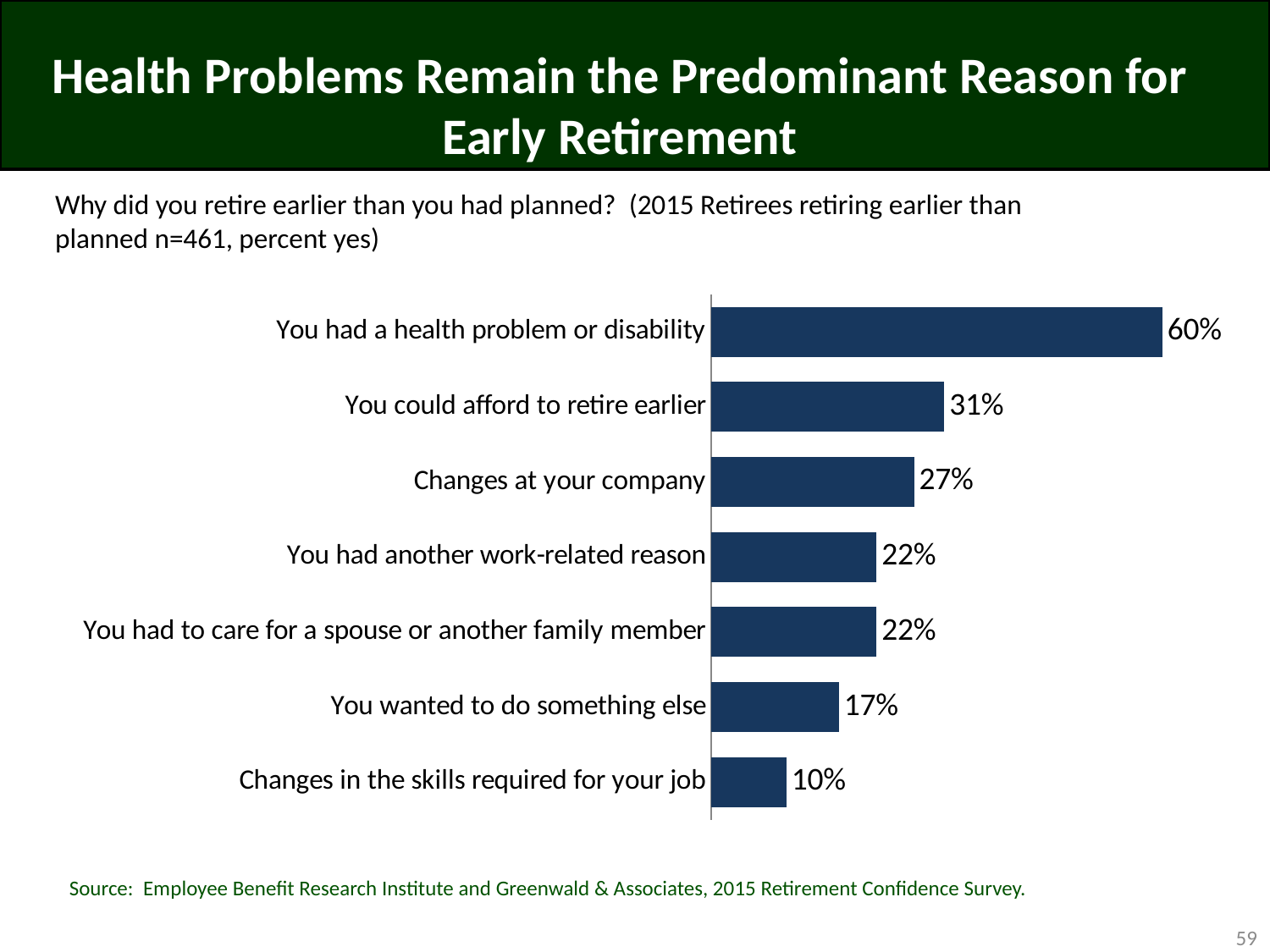
Which is larger: the value for "You could afford to retire earlier" or the value for "Changes at your company"? You could afford to retire earlier Which reason has the highest percentage? You had a health problem or disability What is the difference between "Changes at your company" and "Changes in the skills required for your job"? 17 percentage points Which reason has the lowest percentage? Changes in the skills required for your job What is the difference in percentage points between "You had a health problem or disability" and "You could afford to retire earlier"? 29 percentage points How many reasons (categories) are shown in the chart? 7 What percentage of respondents said they retired early because they had a health problem or disability? 60% Which two reasons share the same value of 22%? You had another work-related reason; You had to care for a spouse or another family member What percentage cited "Changes at your company" as a reason for retiring earlier than planned? 27% What is the value for "You could afford to retire earlier"? 31% What is the value for "You wanted to do something else"? 17% What type of chart is shown on the slide? Bar chart